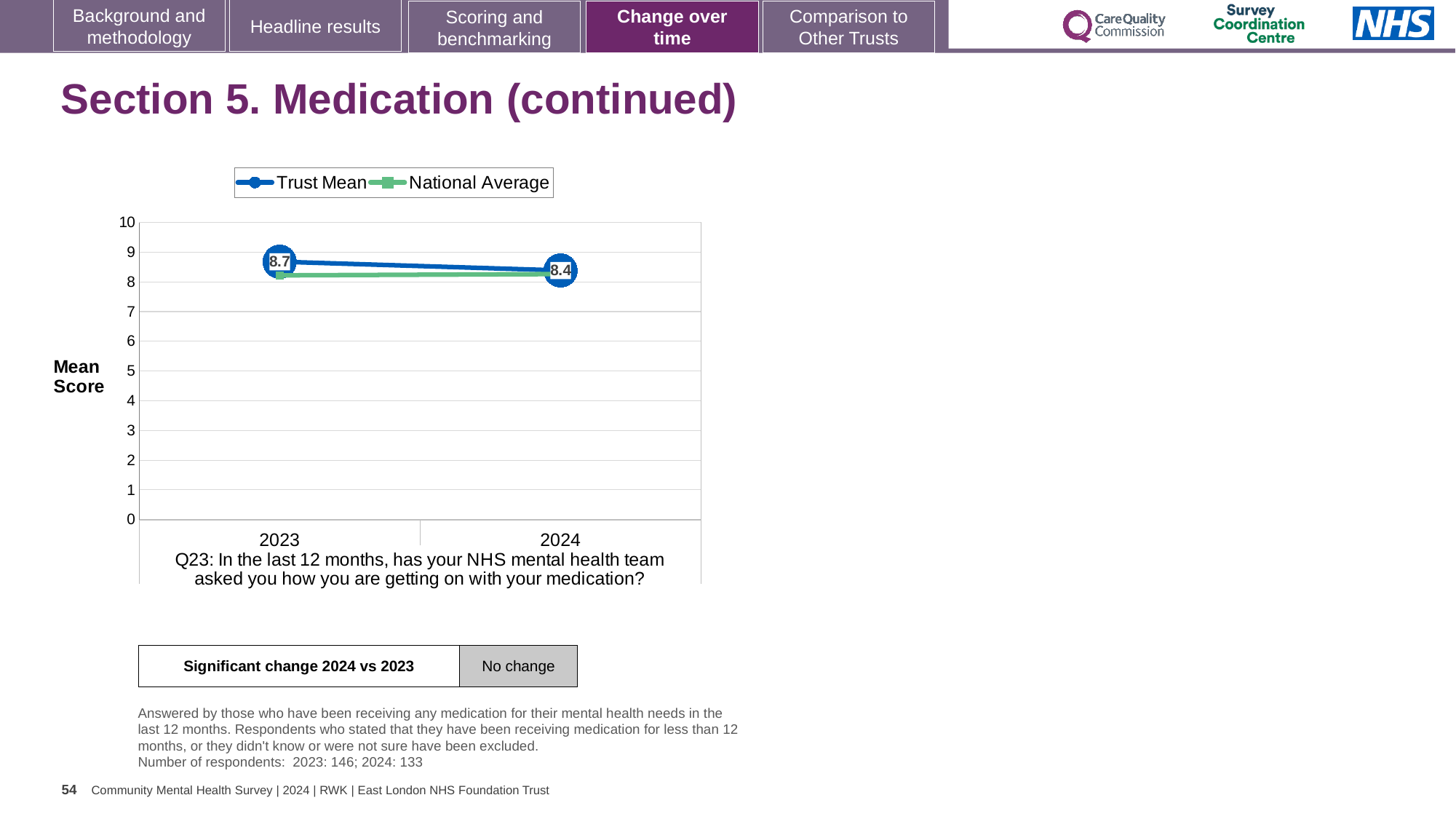
What is the Trust Mean value for 2024? 8.4 What kind of chart is shown on the slide? line chart Is the National Average value for 2023 greater or less than 9? less In which year is the Trust Mean at its highest? 2023 Is the National Average value for 2024 greater or less than 5? greater What is the Trust Mean value for 2023? 8.7 Does the Trust Mean rise or fall from 2023 to 2024? fall How many years are shown on the x axis of the chart? 2 What are the two series named in the chart legend? Trust Mean and National Average How many series does the chart legend list? 2 Which year has the higher Trust Mean, 2023 or 2024? 2023 By how much did the Trust Mean change from 2023 to 2024? 0.3